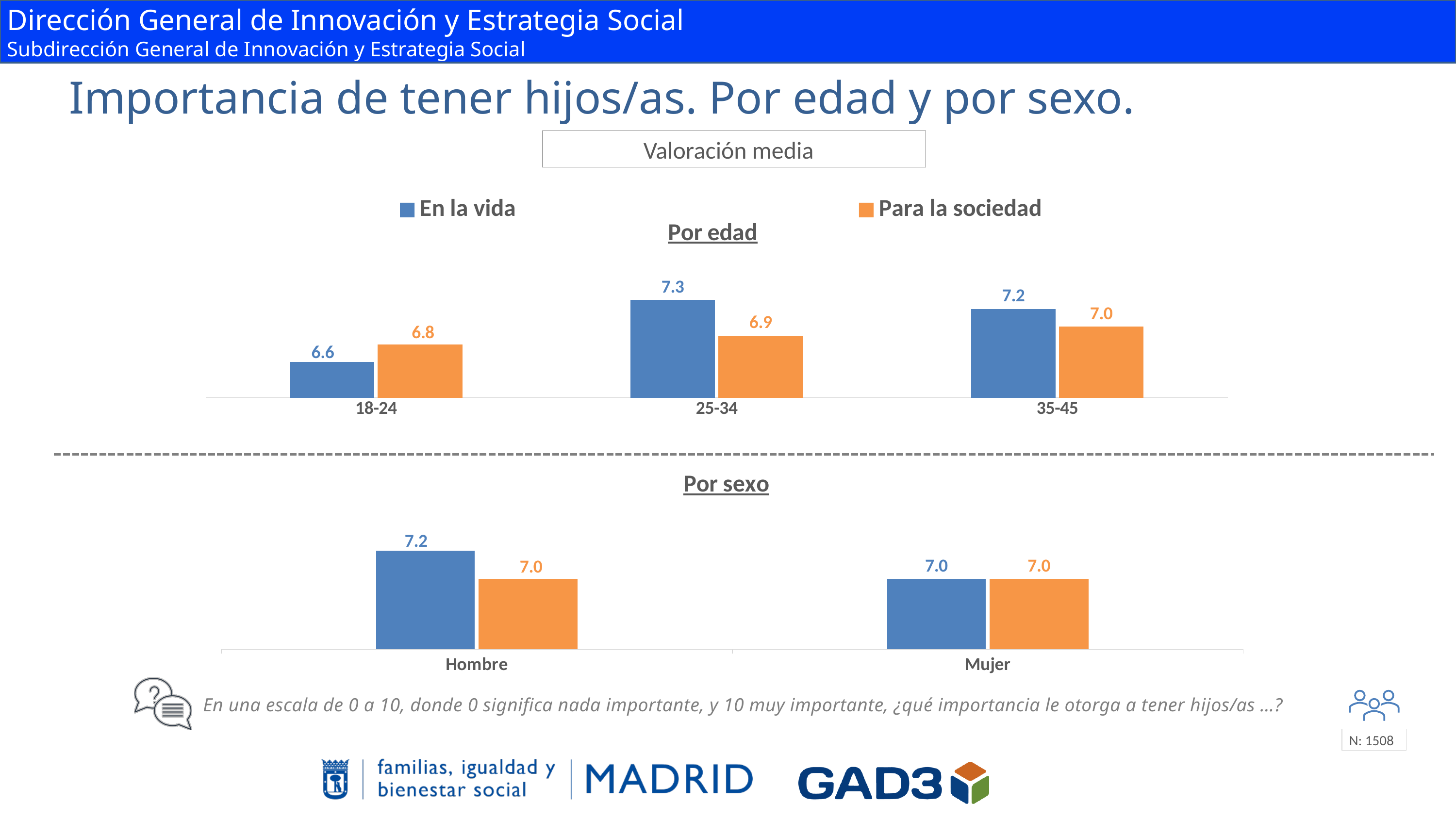
In the 'Por edad' chart, which age group has the lowest 'Para la sociedad' value? 18-24 In the 'Por edad' chart, what is the difference between the 'En la vida' values for 25-34 and 18-24? 0.7 In the 'Por edad' chart, what is the value of 'Para la sociedad' for the 18-24 age group? 6.8 In the 'Por sexo' chart, what is the difference between 'En la vida' and 'Para la sociedad' for Hombre? 0.2 In the 'Por edad' chart, what is the value of 'En la vida' for the 25-34 age group? 7.3 In the 'Por edad' chart, which age group has the highest 'En la vida' value? 25-34 In the 'Por sexo' chart, what is the value of 'Para la sociedad' for Mujer? 7.0 In the 'Por sexo' chart, what is the value of 'En la vida' for Hombre? 7.2 How many age groups are shown in the 'Por edad' chart? 3 What type of chart is the 'Por sexo' chart? Bar chart How many series does the legend list? 2 In the 'Por edad' chart, which is larger for the 18-24 group: 'En la vida' or 'Para la sociedad'? Para la sociedad